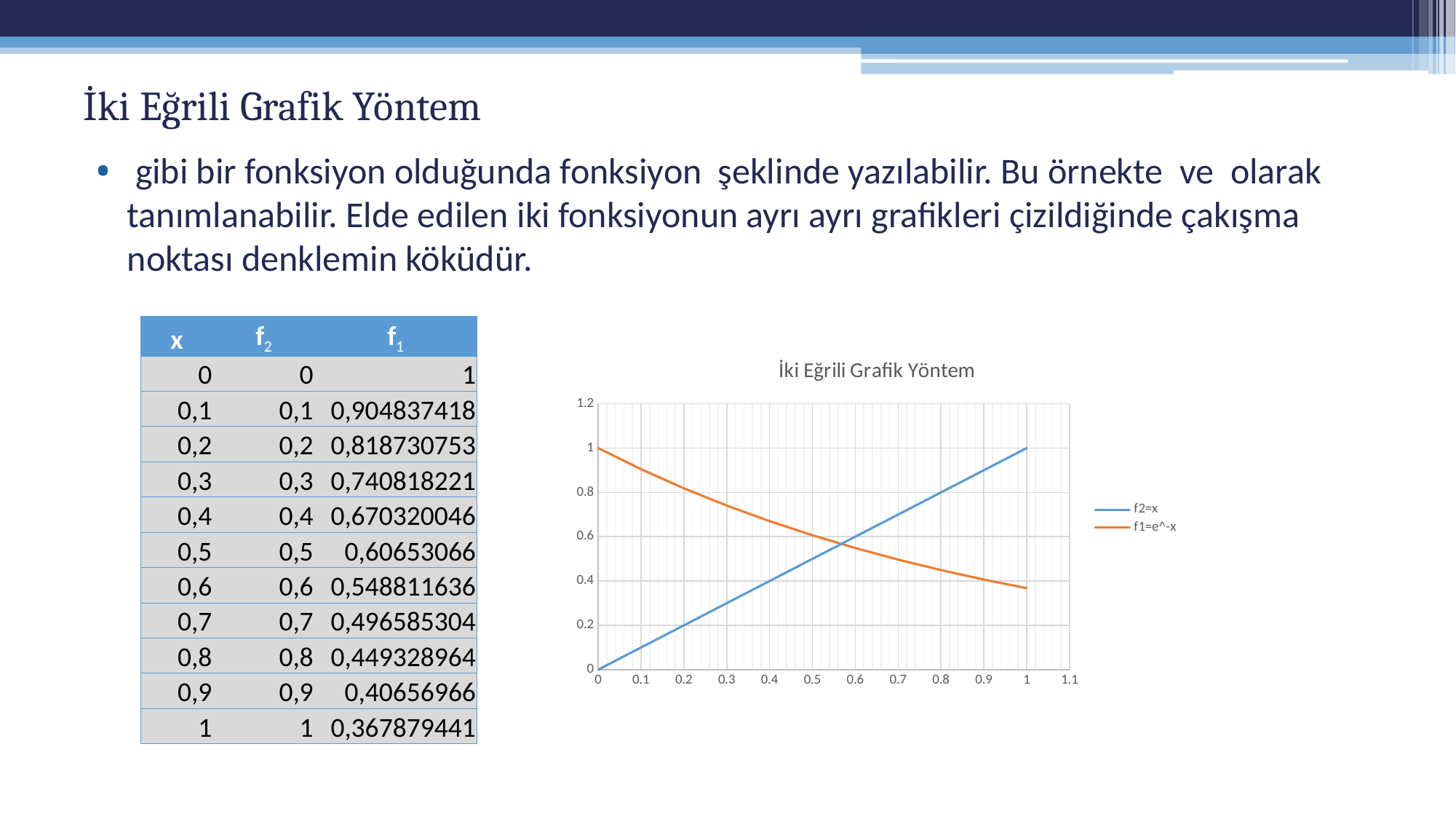
At x = 0.2, which series has the higher value, f2=x or f1=e^-x? f1=e^-x What is the title of the chart? İki Eğrili Grafik Yöntem What are the two series names shown in the chart legend? f2=x and f1=e^-x What is the value of f1=e^-x at x = 0? 1 At which x value does the f1=e^-x series reach its lowest value? 1 Is the value of f1=e^-x at x = 0.8 greater or less than 0.6? less How many series does the chart's legend list? 2 What kind of chart is shown on the slide? line chart Does the f2=x series rise or fall as x increases along the x axis? rise At x = 0.9, which series has the higher value, f2=x or f1=e^-x? f2=x Does the f1=e^-x series rise or fall as x increases along the x axis? fall Is the value of f2=x at x = 0.7 greater or less than 0.6? greater